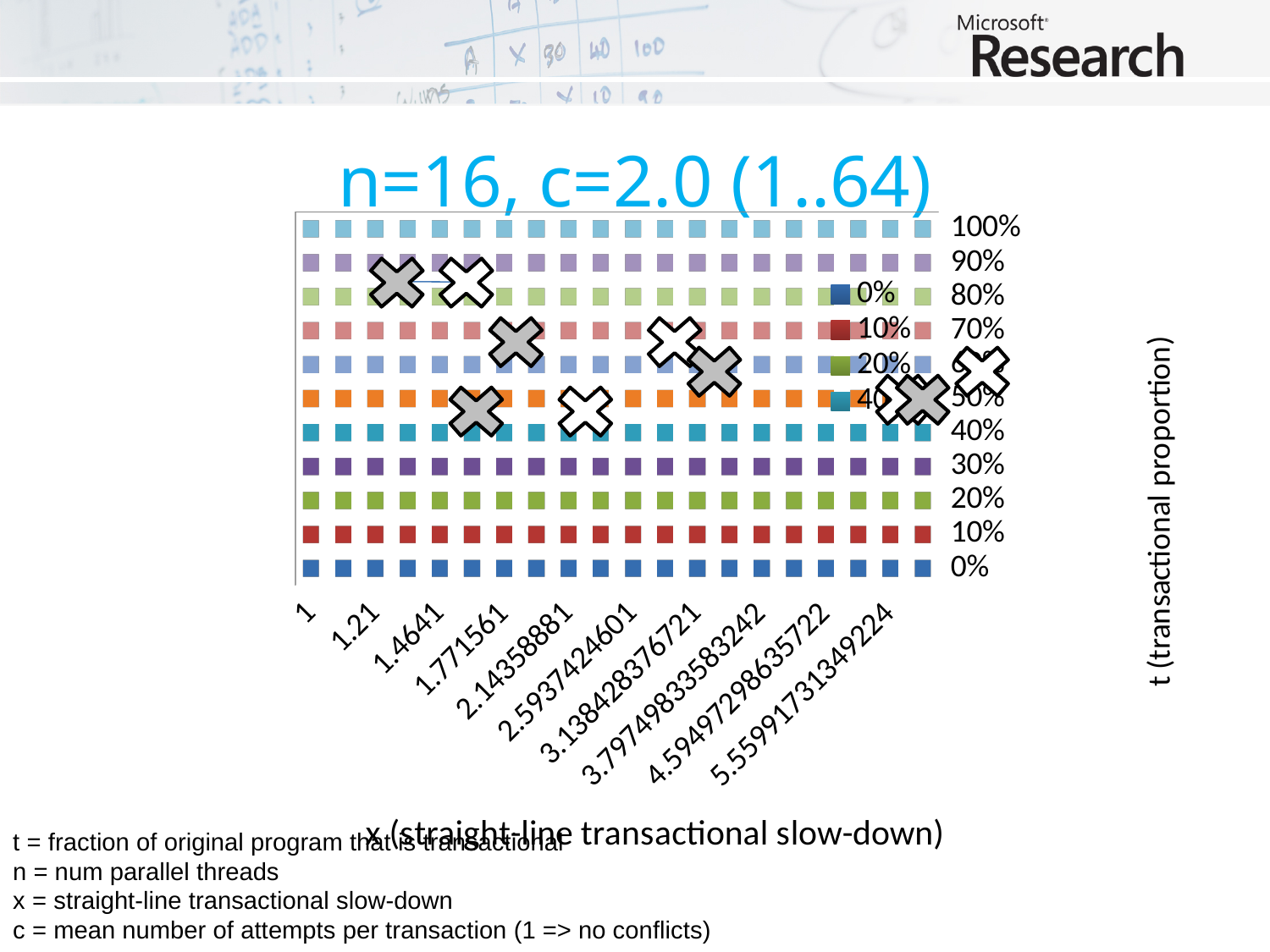
Which x-axis label is larger, 2.14358881 or 3.138428376721? 3.138428376721 What is the second x-axis label on the chart? 1.21 How many rows of markers (t levels) are plotted in the chart? 11 What is the highest t value labelled on the right-hand axis of the chart? 100% What is the last (rightmost) x-axis label on the chart? 5.55991731349224 How many categories are labelled along the x axis of the chart? 10 Do the markers in the 100% row rise, fall, or stay flat as x increases along the x axis? stay flat What kind of chart is shown on the slide? scatter chart What is the lowest t value labelled on the right-hand axis of the chart? 0% What is the title of the chart? n=16, c=2.0 (1..64) What is the first (leftmost) x-axis label on the chart? 1 What is the title of the vertical axis on the right of the chart? t (transactional proportion)